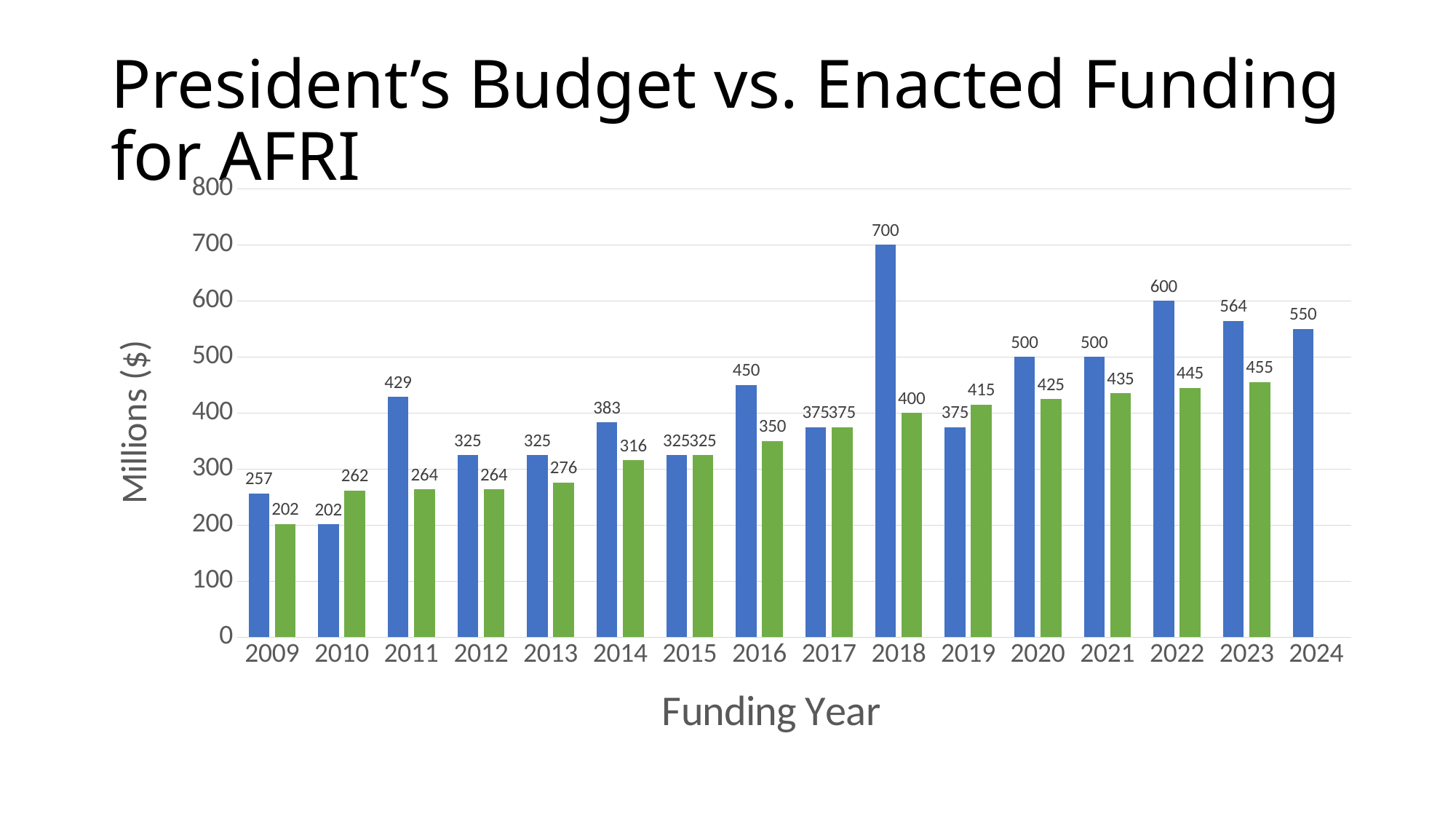
Which year has the highest blue bar? 2018 What is the value of the green bar for 2023? 455 What is the value of the blue bar for 2018? 700 Do the green bars generally rise or fall from 2013 to 2023? rise In 2019, which is larger, the blue bar or the green bar? the green bar What is the difference between the blue bar and the green bar in 2022? 155 What is the value of the blue bar for 2024? 550 What kind of chart is shown on the slide? bar chart What is the difference between the blue bar and the green bar in 2018? 300 How many funding years are shown on the x axis? 16 Which year has the lowest green bar? 2009 What is the label of the x axis? Funding Year